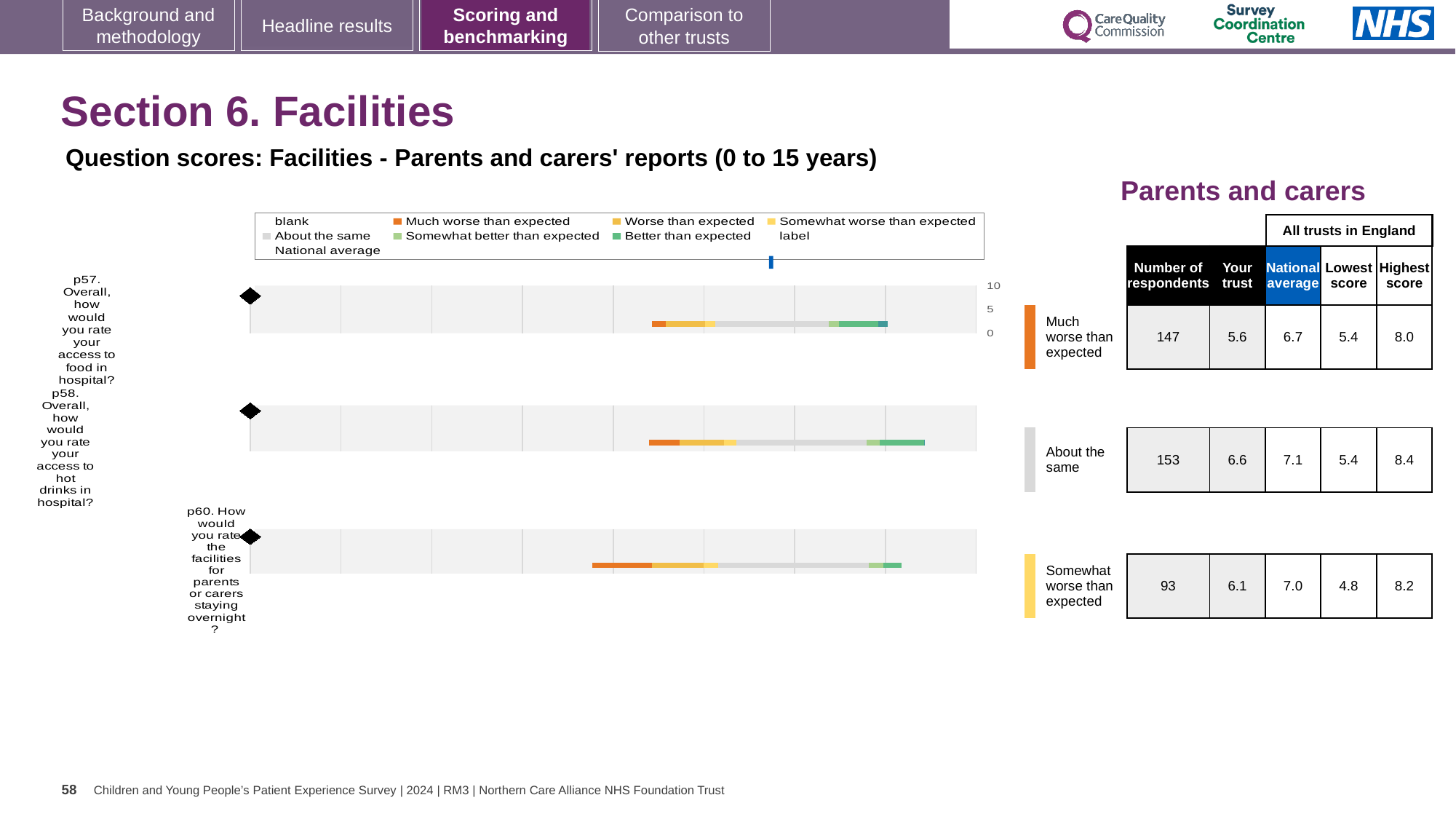
What rating label is shown next to the chart for p60 (facilities for parents or carers staying overnight)? Somewhat worse than expected According to the table beside the chart, what is the 'Your trust' score for p58 (access to hot drinks in hospital)? 6.6 How many questions (bars) are plotted on the slide? 3 Which question has the largest number of respondents? p58 (access to hot drinks in hospital) What rating label is shown next to the chart for p57 (access to food in hospital)? Much worse than expected For p57 (access to food in hospital), which is larger: the 'Your trust' score or the national average? National average Which question has the lowest 'Your trust' score? p57 (access to food in hospital) According to the table beside the chart, what is the highest score among all trusts in England for p58 (access to hot drinks in hospital)? 8.4 According to the table beside the chart, how many respondents answered p57 (access to food in hospital)? 147 For p58 (access to hot drinks in hospital), what is the difference between the highest score and the lowest score among all trusts in England? 3.0 What kind of chart is used to show the question scores for p57, p58 and p60? bar chart According to the table beside the chart, what is the national average for p60 (facilities for parents or carers staying overnight)? 7.0